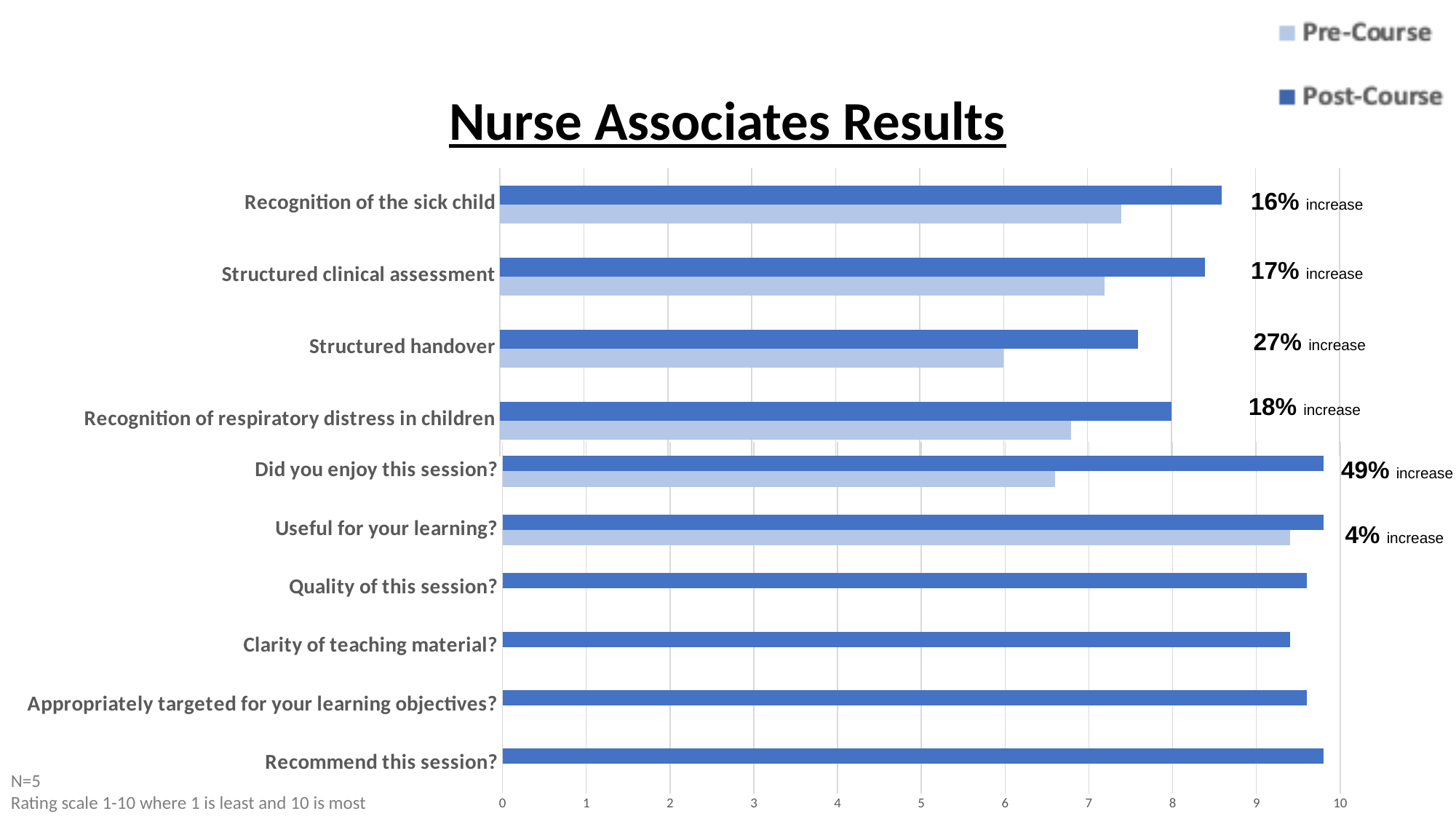
How many series does the legend list? 2 What is the title of the chart? Nurse Associates Results Which has the larger Post-Course value: Recognition of the sick child or Structured handover? Recognition of the sick child What percentage increase is shown for Structured handover? 27% increase What type of chart is shown on the slide? bar chart Is the Post-Course value for Structured handover greater or less than 8? less Which has the larger Pre-Course value: Did you enjoy this session? or Useful for your learning? Useful for your learning? Which category shows the largest percentage increase? Did you enjoy this session? Which category shows the smallest percentage increase? Useful for your learning? Is the Pre-Course value for Did you enjoy this session? greater or less than 7? less How many categories are shown on the chart? 10 Is the Pre-Course value for Recognition of the sick child greater or less than 7? greater